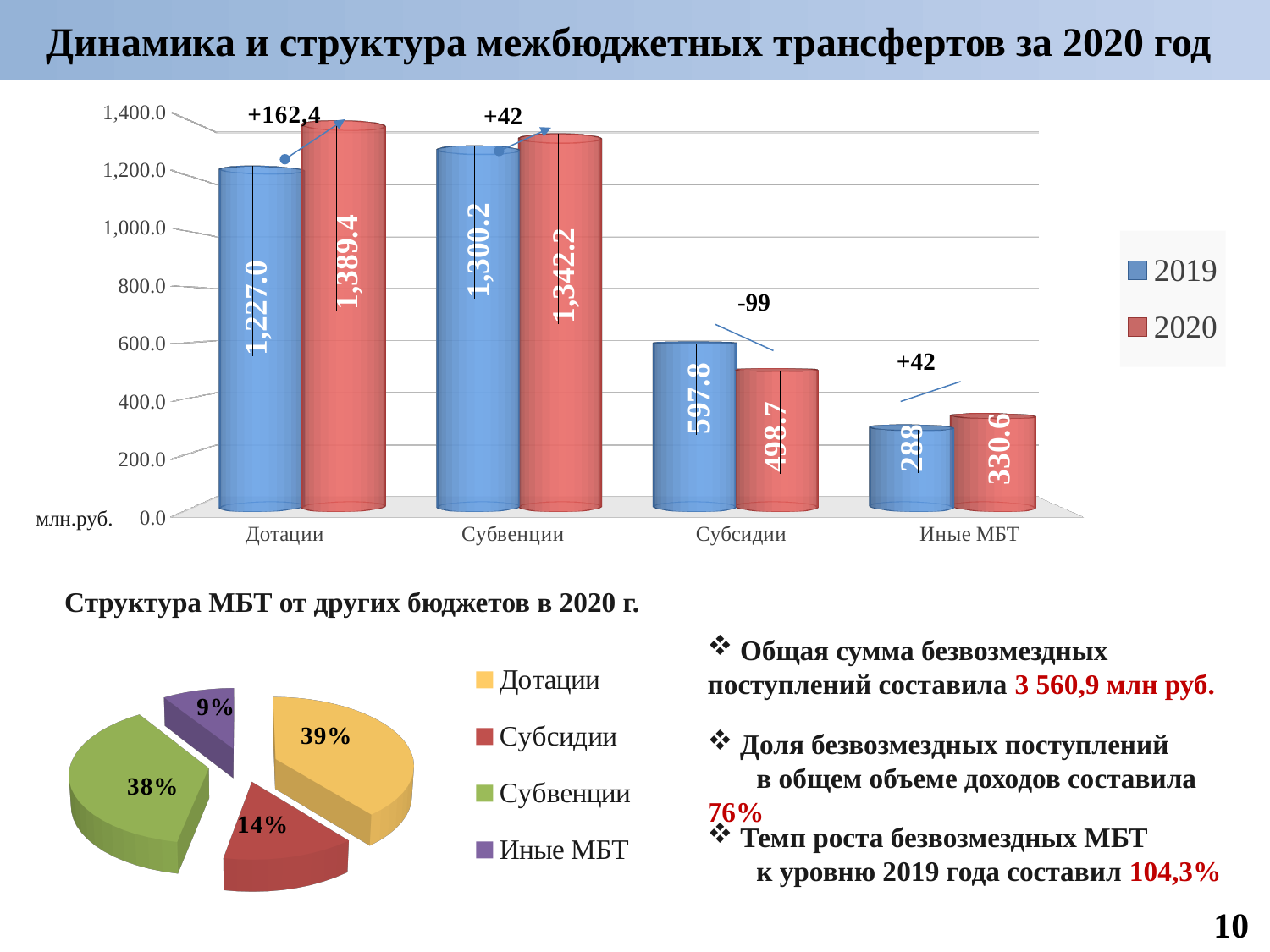
In the bar chart at the top of the slide, what is the difference between the 2020 and 2019 values for Субсидии? 99.1 In the bar chart at the top of the slide, what is the value for Субсидии in 2019? 597.8 In the bar chart at the top of the slide, what is the value for Дотации in 2020? 1,389.4 In the bar chart at the top of the slide, which is larger for Субвенции: the 2019 value or the 2020 value? 2020 In the bar chart at the top of the slide, how many series does the legend list? 2 In the bar chart at the top of the slide, what is the value for Иные МБТ in 2020? 330.6 In the bar chart at the top of the slide, how many categories are shown on the x axis? 4 In the bar chart at the top of the slide, which category has the lowest value in 2019? Иные МБТ In the bar chart at the top of the slide, which category has the highest value in 2020? Дотации In the pie chart 'Структура МБТ от других бюджетов в 2020 г.', which category has the smallest slice? Иные МБТ In the pie chart 'Структура МБТ от других бюджетов в 2020 г.', what share does Субвенции have? 38% What kind of chart is the chart at the top of the slide? Bar chart